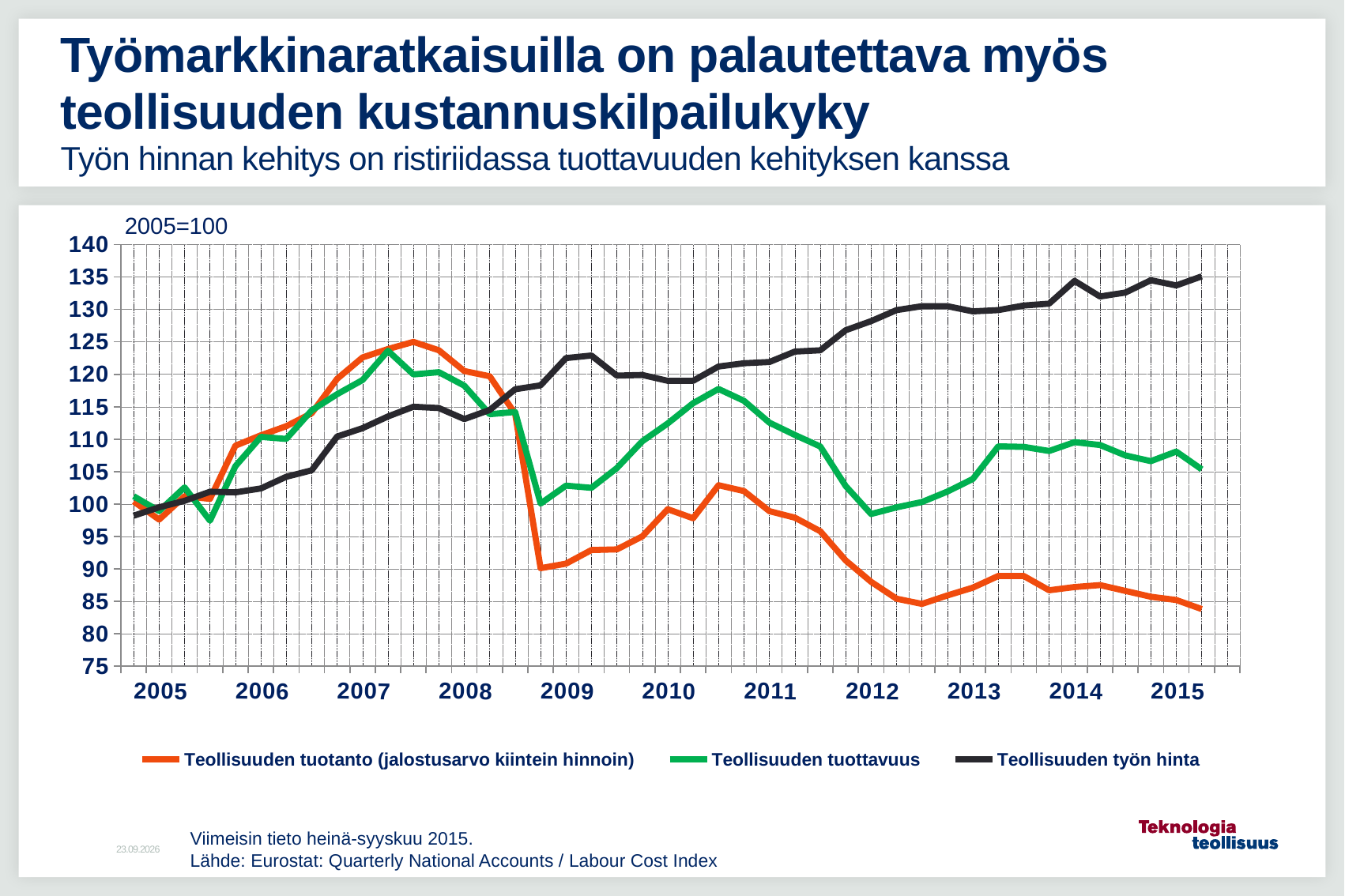
How many series does the legend list? 3 What are the three series named in the legend? Teollisuuden tuotanto (jalostusarvo kiintein hinnoin), Teollisuuden tuottavuus, Teollisuuden työn hinta Which series has the highest value at the end of 2015? Teollisuuden työn hinta Which series has the lowest value at the end of 2015? Teollisuuden tuotanto (jalostusarvo kiintein hinnoin) Is the value for Teollisuuden tuotanto (jalostusarvo kiintein hinnoin) at the start of 2009 greater or less than 95? less Does Teollisuuden työn hinta rise or fall overall from 2005 to 2015? rise Is the value for Teollisuuden tuotanto (jalostusarvo kiintein hinnoin) at the end of 2015 greater or less than 90? less How many year labels are shown on the x axis? 11 What kind of chart is shown on the slide? line chart Is the value for Teollisuuden tuottavuus at the end of 2015 greater or less than 100? greater What base year and index value is stated above the chart? 2005=100